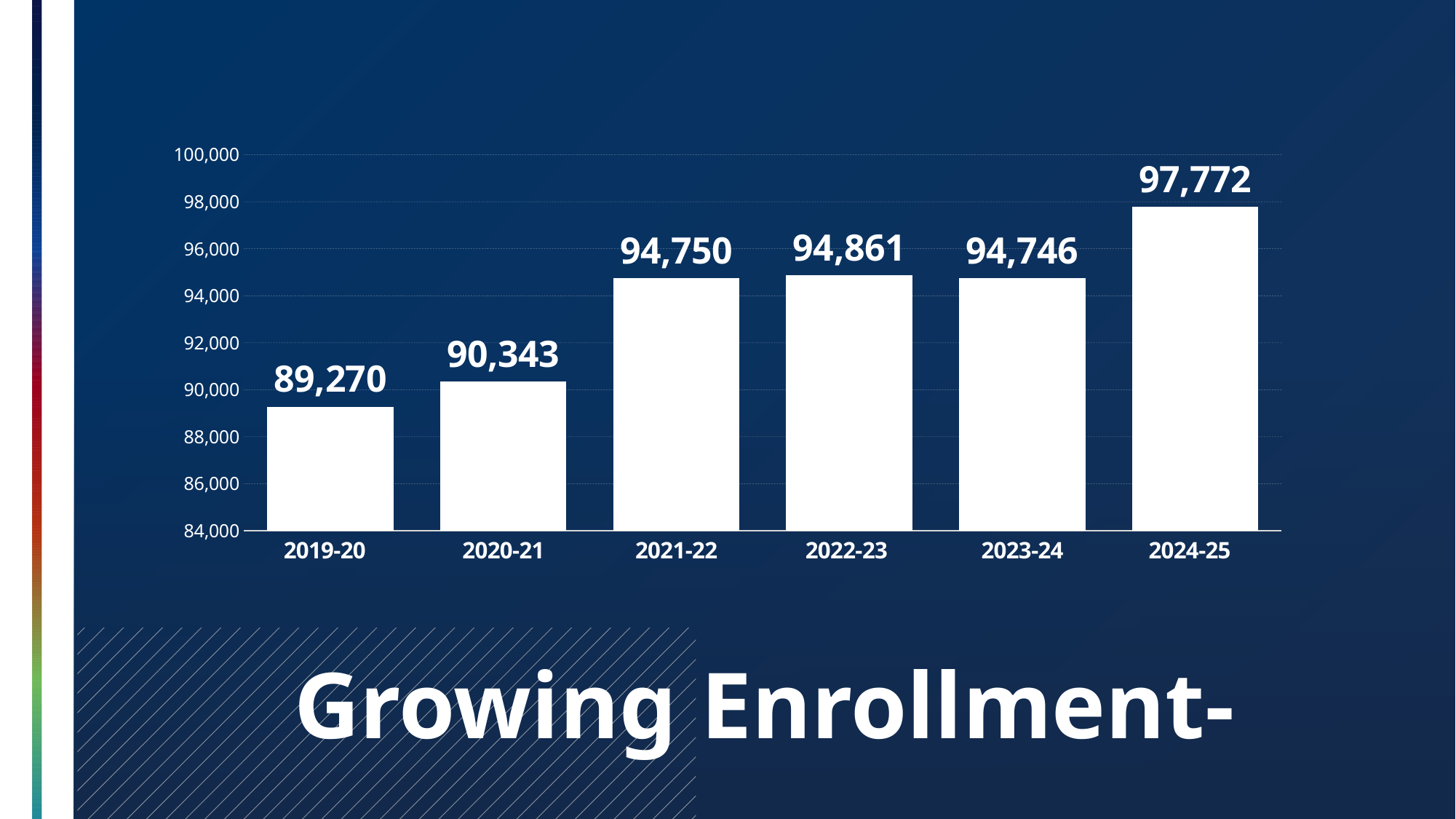
What is the enrollment value for 2022-23? 94,861 Is the enrollment value for 2023-24 greater or less than 96,000? less Which year has the lowest enrollment? 2019-20 What kind of chart is shown on the slide? bar chart What is the enrollment value for 2019-20? 89,270 What is the difference between the 2024-25 and 2019-20 enrollment values? 8,502 Which is larger, the enrollment for 2021-22 or for 2020-21? 2021-22 How many years are shown on the chart? 6 What is the difference between the 2020-21 and 2019-20 enrollment values? 1,073 Which year has the highest enrollment? 2024-25 Do the enrollment values rise or fall from 2019-20 to 2021-22? rise What is the enrollment value for 2024-25? 97,772